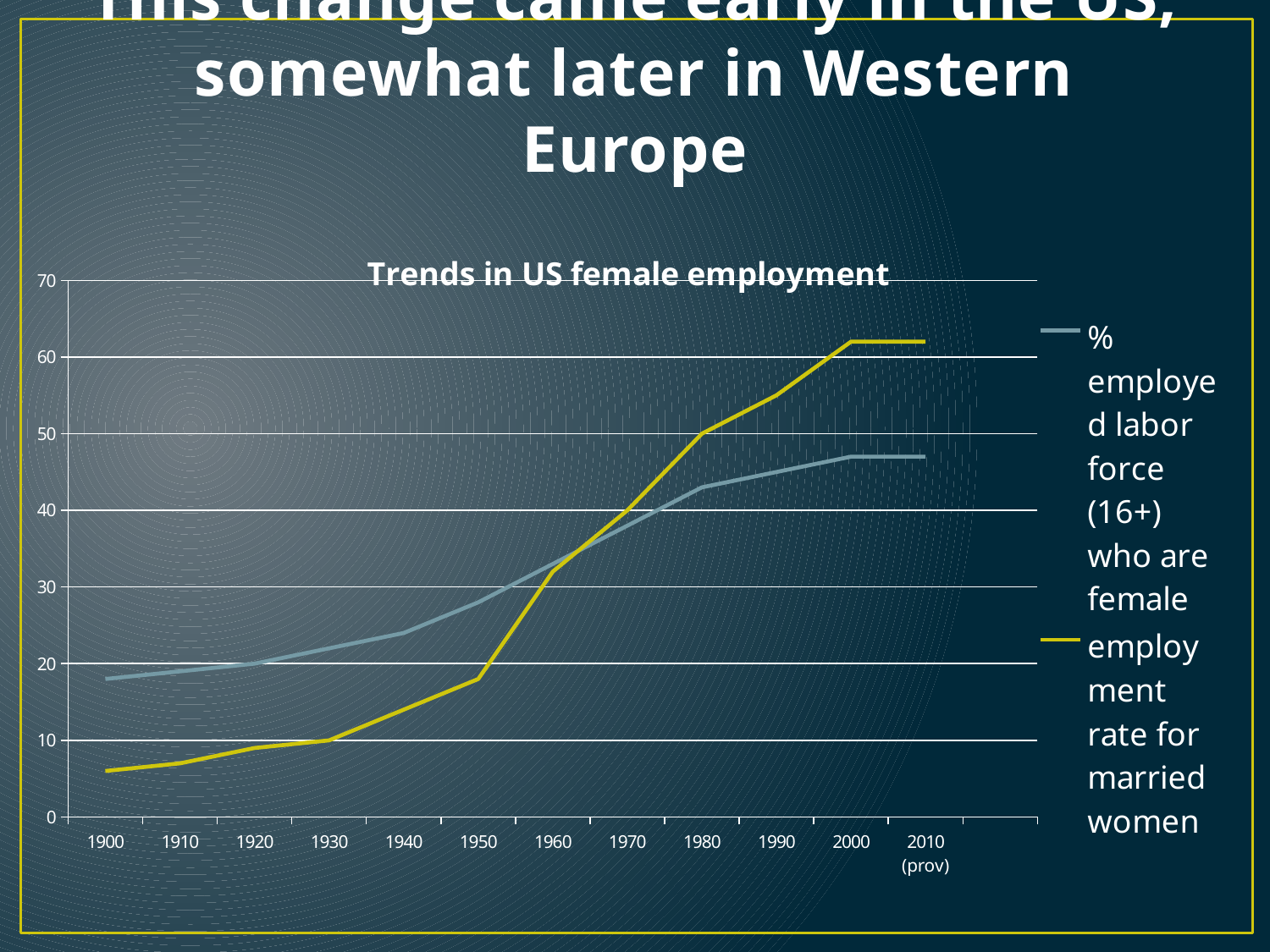
Is the employment rate for married women in 2000 greater or less than 60? greater Is the % employed labor force (16+) who are female in 1900 greater or less than 20? less What kind of chart is shown on the slide? line chart Is the % employed labor force (16+) who are female in 2000 greater or less than 40? greater Does the employment rate for married women rise or fall from 1900 to 2000? rise How many years are marked along the x axis? 12 How many series does the legend list? 2 In 2000, which series has the higher value: % employed labor force who are female, or employment rate for married women? employment rate for married women In 1900, which series has the higher value: % employed labor force who are female, or employment rate for married women? % employed labor force (16+) who are female What is the title of the chart? Trends in US female employment